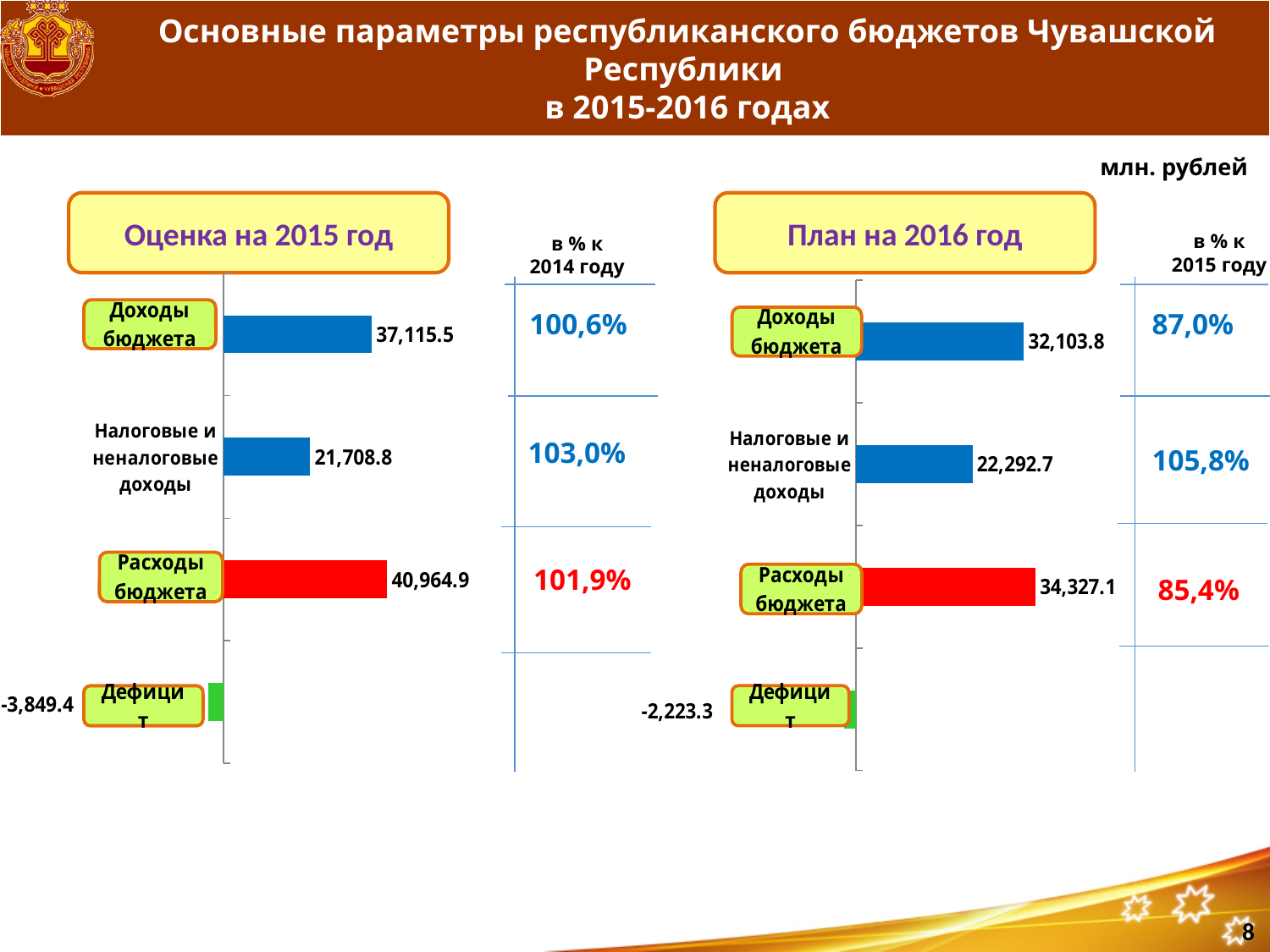
In the chart titled "Оценка на 2015 год", what is the value for "Доходы бюджета"? 37,115.5 What type of chart is the "План на 2016 год" chart? Bar chart In the chart titled "План на 2016 год", which is larger: "Доходы бюджета" or "Расходы бюджета"? Расходы бюджета In the chart titled "Оценка на 2015 год", what is the value for "Дефицит"? -3,849.4 In the chart titled "План на 2016 год", what is the value for "Расходы бюджета"? 34,327.1 In the chart titled "Оценка на 2015 год", which category has the highest value? Расходы бюджета In the chart titled "Оценка на 2015 год", what colour is the bar for "Расходы бюджета"? Red In the chart titled "План на 2016 год", what is the value for "Налоговые и неналоговые доходы"? 22,292.7 What is the difference between "Доходы бюджета" in the "Оценка на 2015 год" chart and "Доходы бюджета" in the "План на 2016 год" chart? 5,011.7 In the chart titled "План на 2016 год", which category has the lowest value? Дефицит In the chart titled "Оценка на 2015 год", what is the difference between "Расходы бюджета" and "Доходы бюджета"? 3,849.4 How many categories are shown in the chart titled "Оценка на 2015 год"? 4